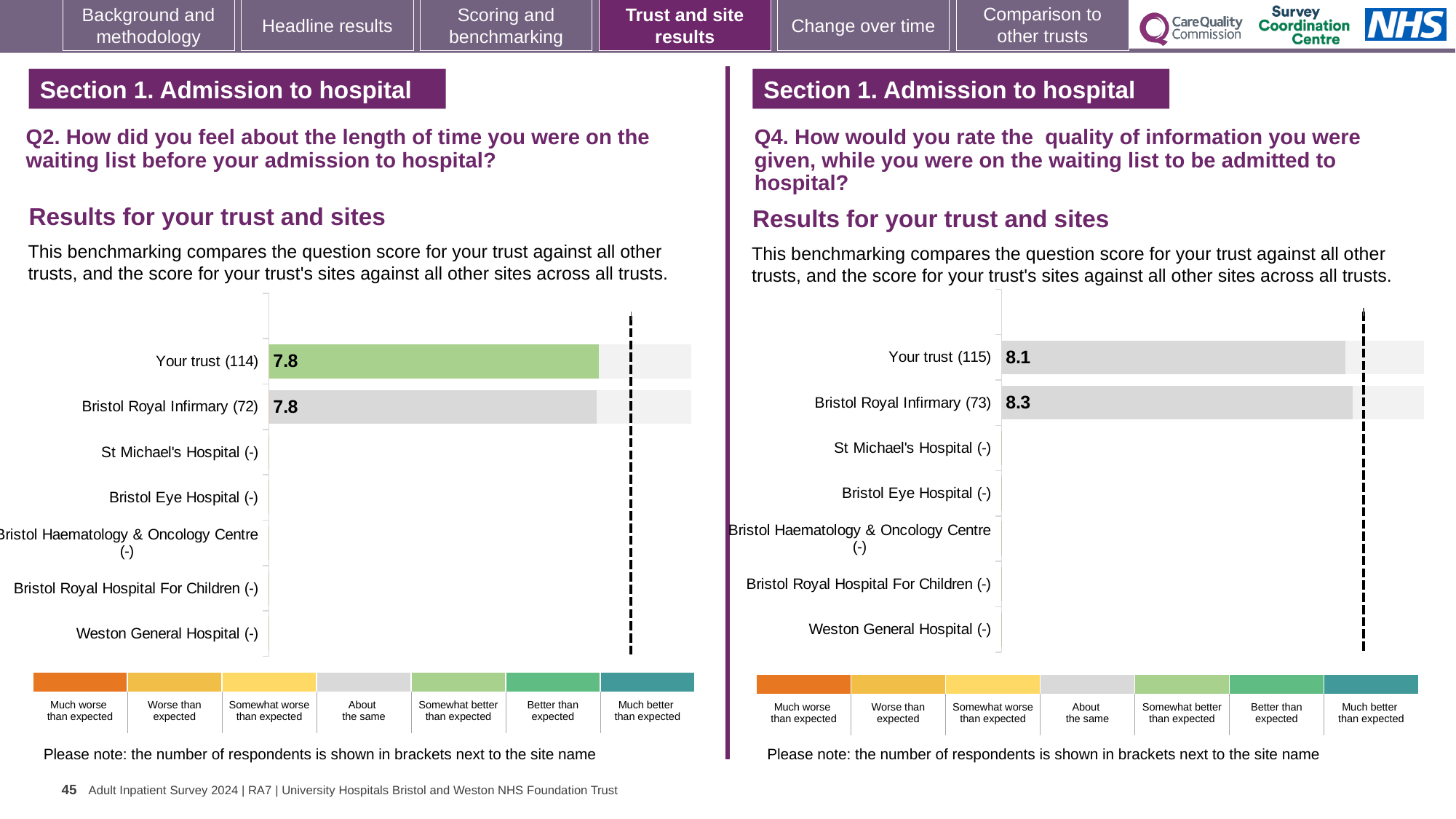
What kind of chart is used for the Q2 results on the left? Bar chart In the Q2 chart on the left, what is the score for Bristol Royal Infirmary (72)? 7.8 In the Q4 chart on the right, which has the higher score, Your trust or Bristol Royal Infirmary? Bristol Royal Infirmary In the Q4 chart on the right, what is the score for Bristol Royal Infirmary (73)? 8.3 In the Q2 chart on the left, what is the score for Your trust (114)? 7.8 In the Q4 chart on the right, what is the difference between the Bristol Royal Infirmary score and the Your trust score? 0.2 In the Q4 chart on the right, what is the score for Your trust (115)? 8.1 How many site/trust categories are listed on the y axis of the Q2 chart on the left? 7 How many site/trust categories are listed on the y axis of the Q4 chart on the right? 7 In the Q2 chart on the left, what is the difference between the Your trust score and the Bristol Royal Infirmary score? 0 How many respondents are shown in brackets for Your trust in the Q4 chart on the right? 115 In the Q2 chart on the left, which benchmark category does the colour of the Your trust bar correspond to according to the legend? Somewhat better than expected